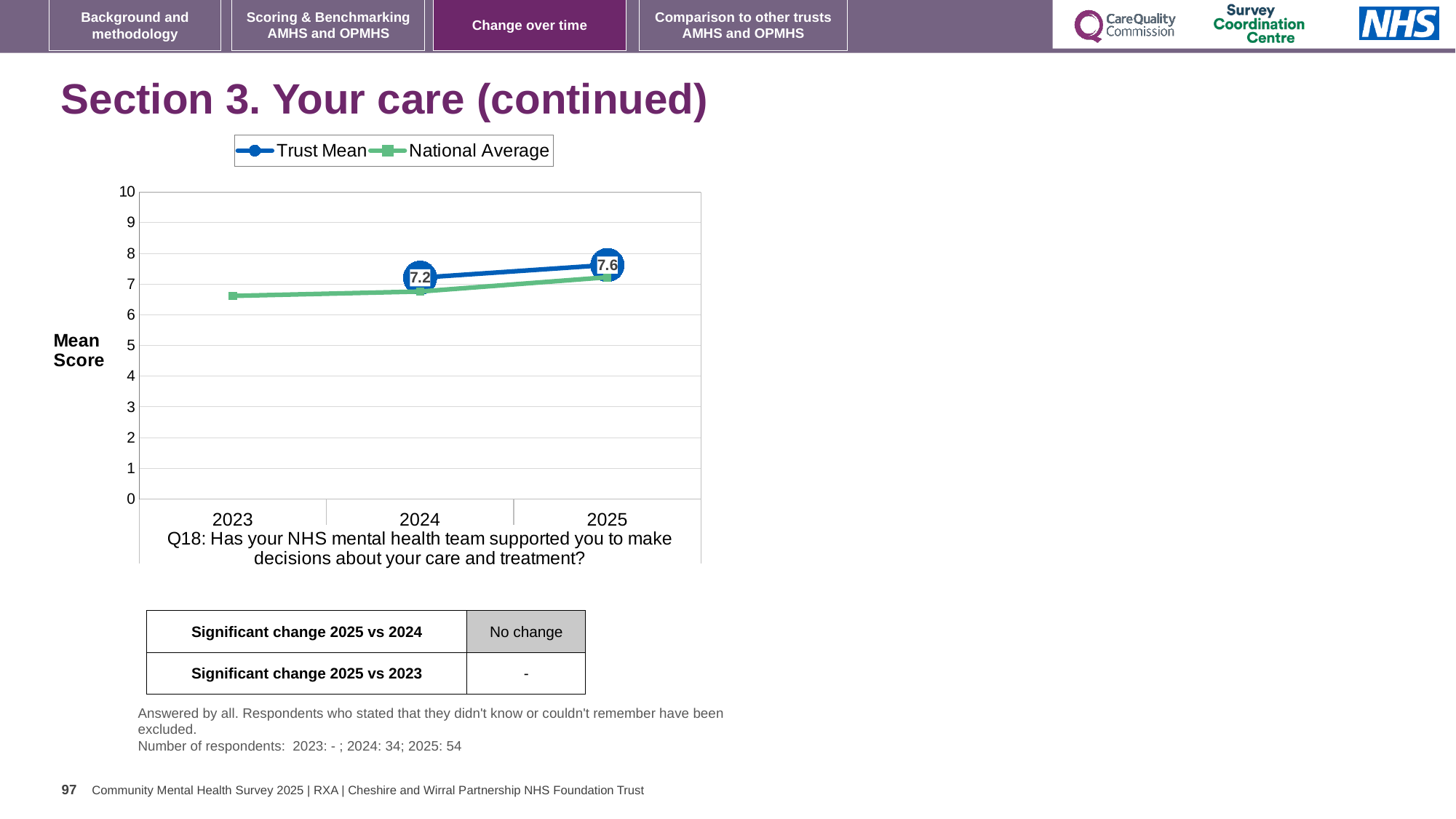
What is the label of the y axis of the chart? Mean Score What is the Trust Mean score for 2024? 7.2 What is the Trust Mean score for 2025? 7.6 By how much did the Trust Mean score change from 2024 to 2025? 0.4 Does the Trust Mean rise or fall from 2024 to 2025? rise How many series does the chart legend list? 2 Is the National Average for 2023 greater or less than 7? less What kind of chart is shown on the slide? line chart In which year is the Trust Mean score highest? 2025 In 2025, which is higher: the Trust Mean or the National Average? Trust Mean How many years are shown on the x axis of the chart? 3 Is the National Average for 2025 greater or less than 8? less